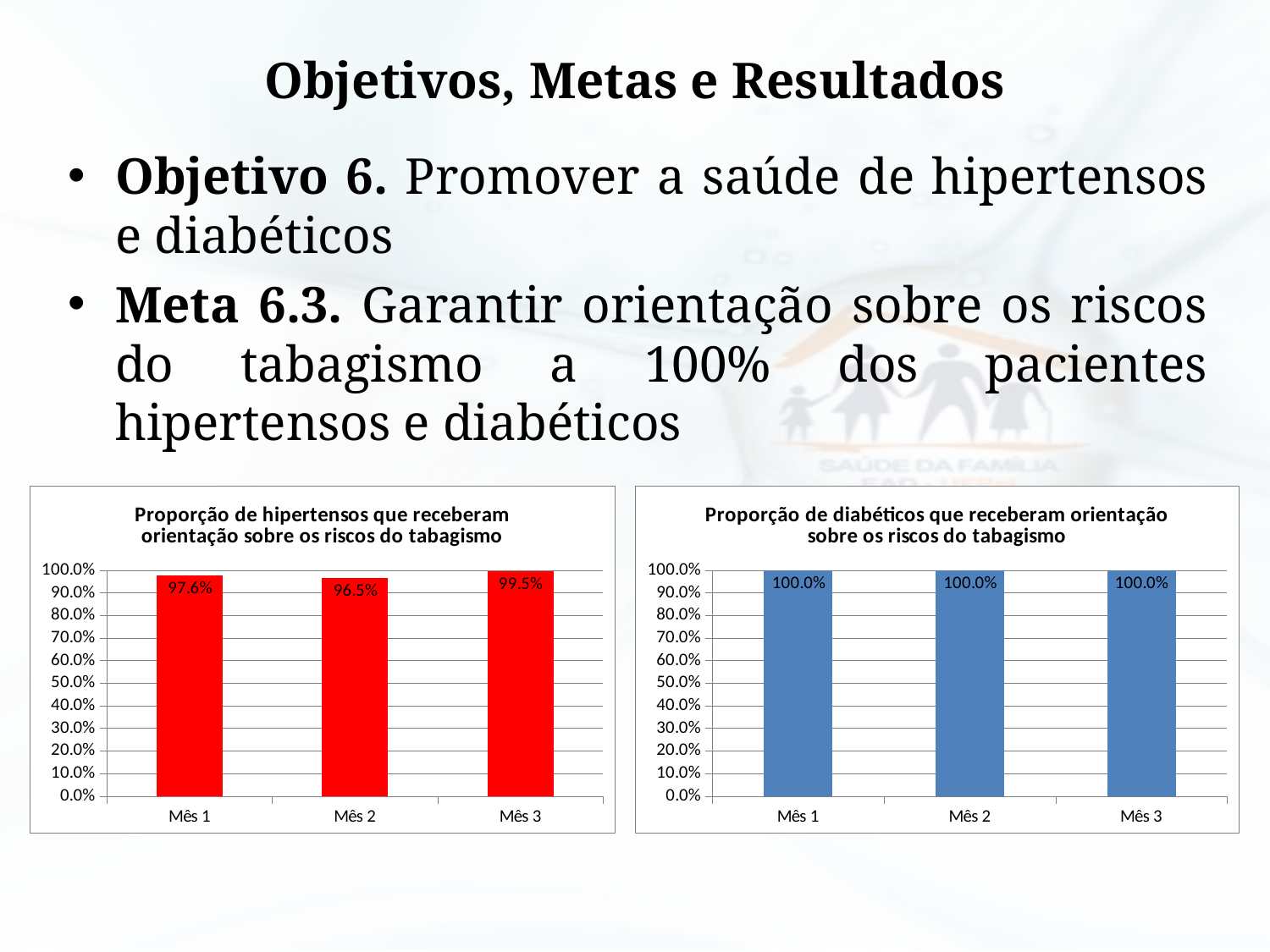
In the left chart (Proporção de hipertensos que receberam orientação sobre os riscos do tabagismo), which month has the lowest value? Mês 2 In the left chart (Proporção de hipertensos que receberam orientação sobre os riscos do tabagismo), which month has the highest value? Mês 3 What colour are the bars in the right chart (Proporção de diabéticos que receberam orientação sobre os riscos do tabagismo)? Blue In the right chart (Proporção de diabéticos que receberam orientação sobre os riscos do tabagismo), what is the value for Mês 2? 100.0% In the left chart (Proporção de hipertensos que receberam orientação sobre os riscos do tabagismo), what is the value for Mês 2? 96.5% In the left chart (Proporção de hipertensos que receberam orientação sobre os riscos do tabagismo), what is the value for Mês 1? 97.6% In the left chart (Proporção de hipertensos que receberam orientação sobre os riscos do tabagismo), which is larger, the value for Mês 1 or Mês 2? Mês 1 In the left chart (Proporção de hipertensos que receberam orientação sobre os riscos do tabagismo), what is the difference between the values for Mês 3 and Mês 2? 3.0% What kind of chart is the right chart (Proporção de diabéticos que receberam orientação sobre os riscos do tabagismo)? Bar chart In the right chart (Proporção de diabéticos que receberam orientação sobre os riscos do tabagismo), how many months are plotted? 3 In the left chart (Proporção de hipertensos que receberam orientação sobre os riscos do tabagismo), is the value for Mês 2 greater or less than 90.0%? greater In the left chart (Proporção de hipertensos que receberam orientação sobre os riscos do tabagismo), what is the value for Mês 3? 99.5%